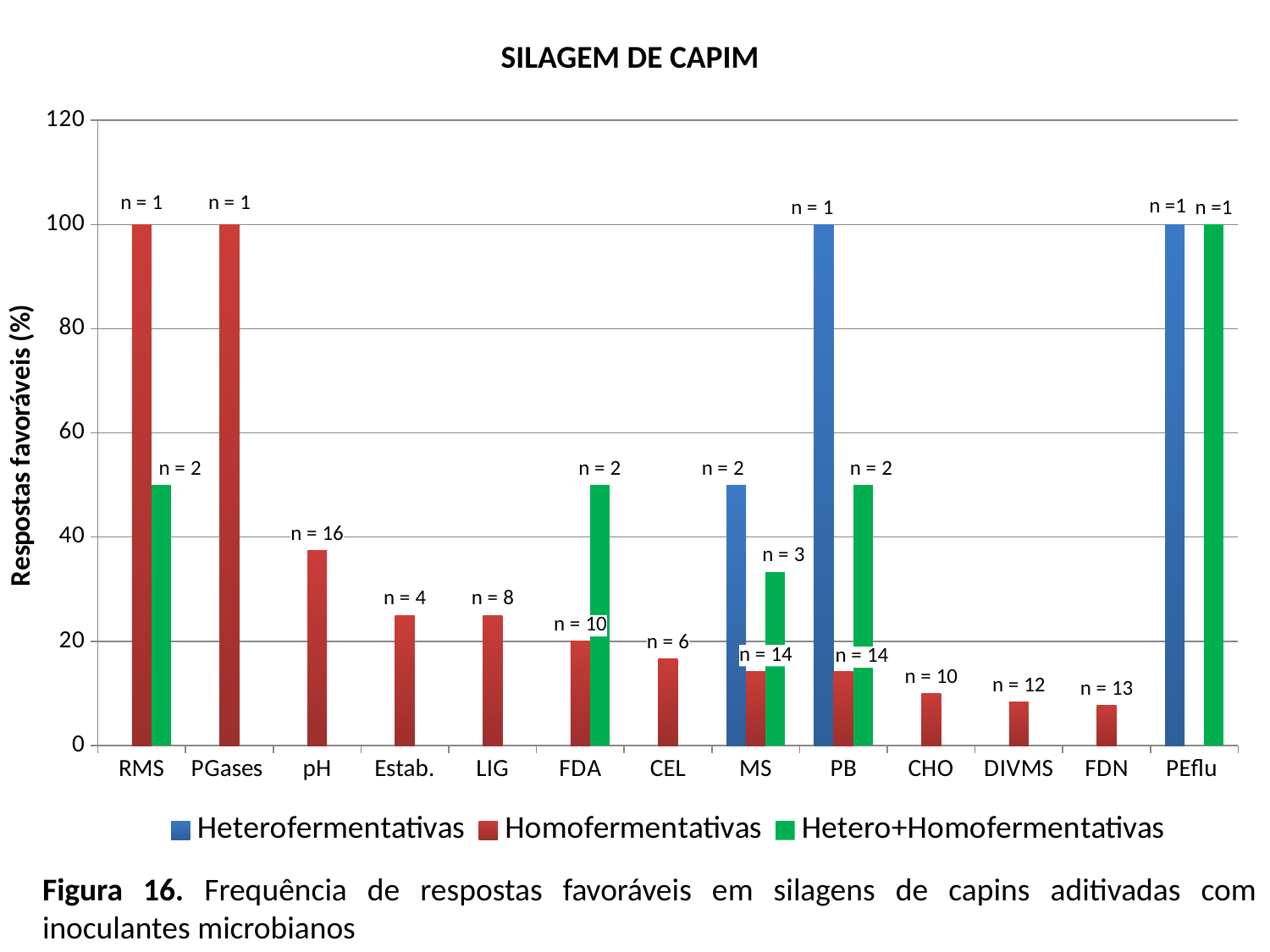
Is the value of the Homofermentativas bar for CHO greater or less than 20? less What is the value of the Heterofermentativas bar for PB? 100 What is the value of the Homofermentativas bar for FDA? 20 Is the value of the Homofermentativas bar for pH greater or less than 40? less How many series does the legend list? 3 How many categories are shown on the x axis? 13 For MS, which is larger: the Heterofermentativas bar or the Homofermentativas bar? Heterofermentativas What is the title of the chart? SILAGEM DE CAPIM What type of chart is shown on the slide? bar chart What is the value of the Homofermentativas bar for RMS? 100 What n value is printed above the Homofermentativas bar for pH? n = 16 Is the value of the Hetero+Homofermentativas bar for FDA greater or less than 40? greater